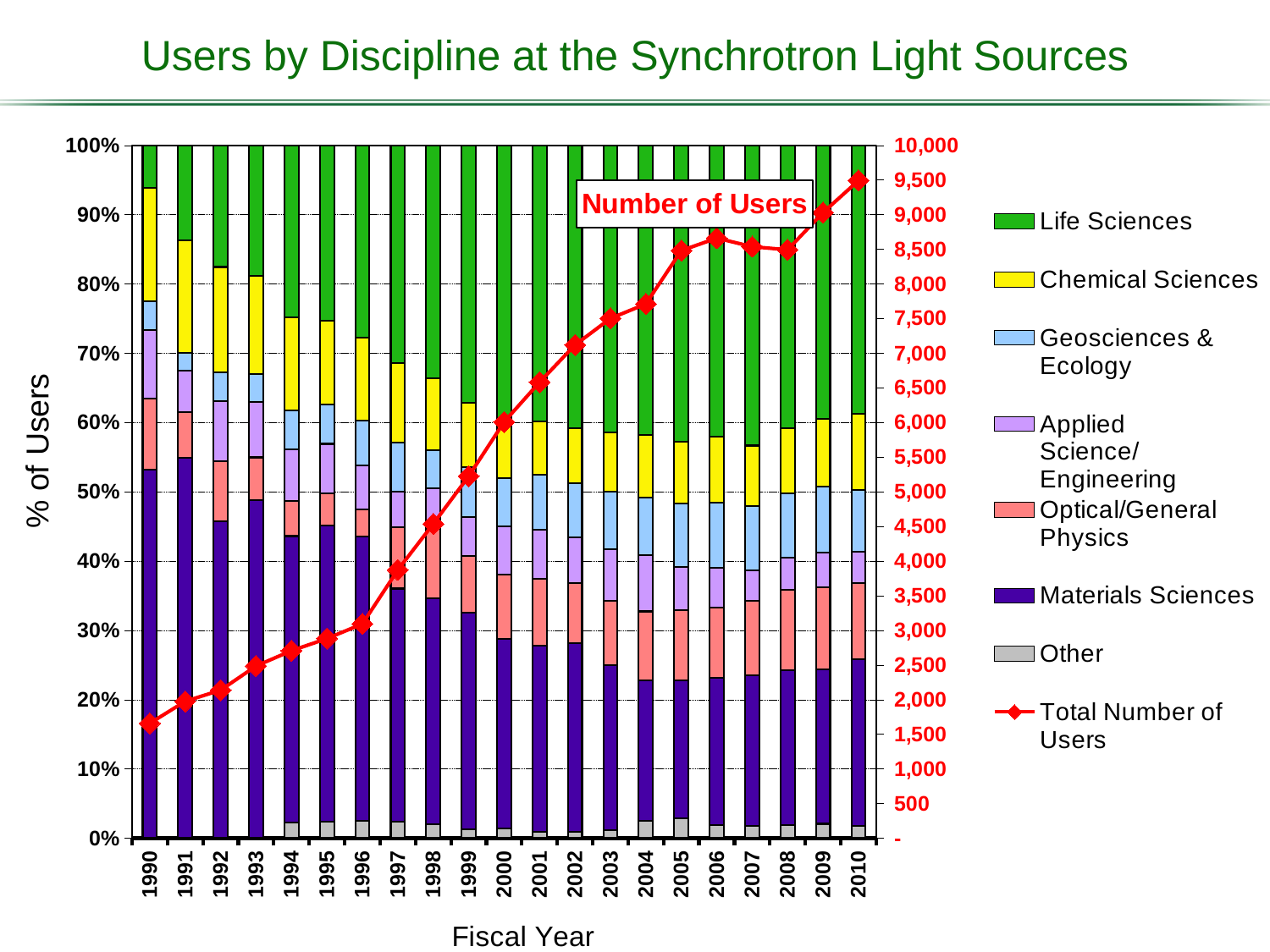
How many fiscal years are shown along the x axis? 21 Is the Total Number of Users in 2010 greater or less than 9,000? greater Which fiscal year has the highest Total Number of Users? 2010 Is the Materials Sciences share of users in 2010 greater or less than 30%? less Which fiscal year has the lowest Total Number of Users? 1990 Is the Materials Sciences share of users larger in 1990 or in 2010? 1990 What colour represents Life Sciences in the chart? Green Is the Materials Sciences share of users in 1990 greater or less than 50%? greater Does the Total Number of Users line generally rise or fall from 1990 to 2010? Rise How many entries does the legend list? 8 What kind of chart is shown on the slide? Stacked bar chart with a line overlay